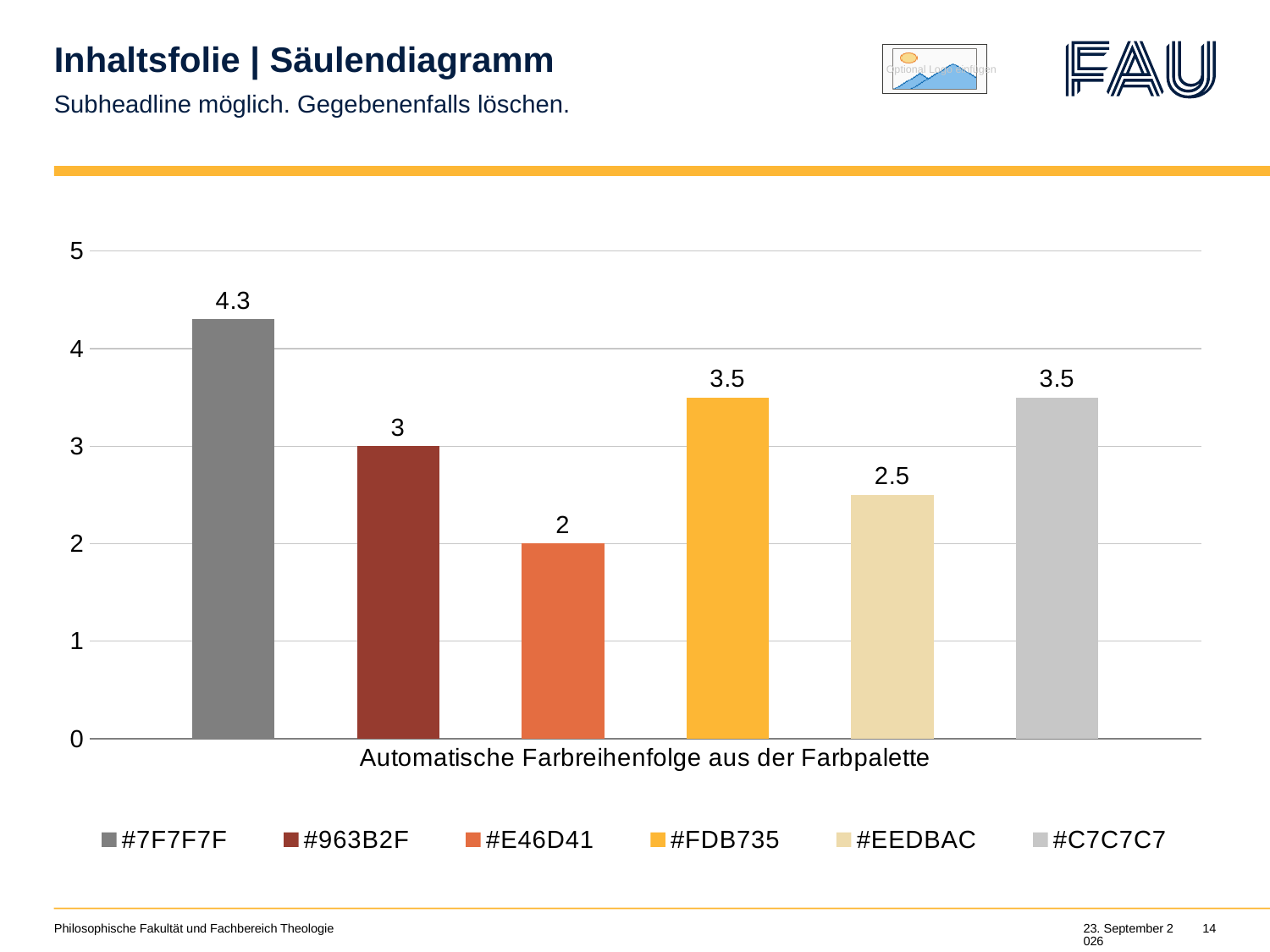
What is the value for the #C7C7C7 series? 3.5 Which series has the lowest value? #E46D41 What is the difference between the values for #7F7F7F and #963B2F? 1.3 Is the value for #963B2F greater or less than 4? less Which is larger, the value for #FDB735 or the value for #EEDBAC? #FDB735 What is the value for the #E46D41 series? 2 What is the value for the #EEDBAC series? 2.5 What kind of chart is shown on the slide? bar chart What is the value for the #7F7F7F series? 4.3 What is the category label shown on the x axis? Automatische Farbreihenfolge aus der Farbpalette Which series has the highest value? #7F7F7F How many series does the legend list? 6